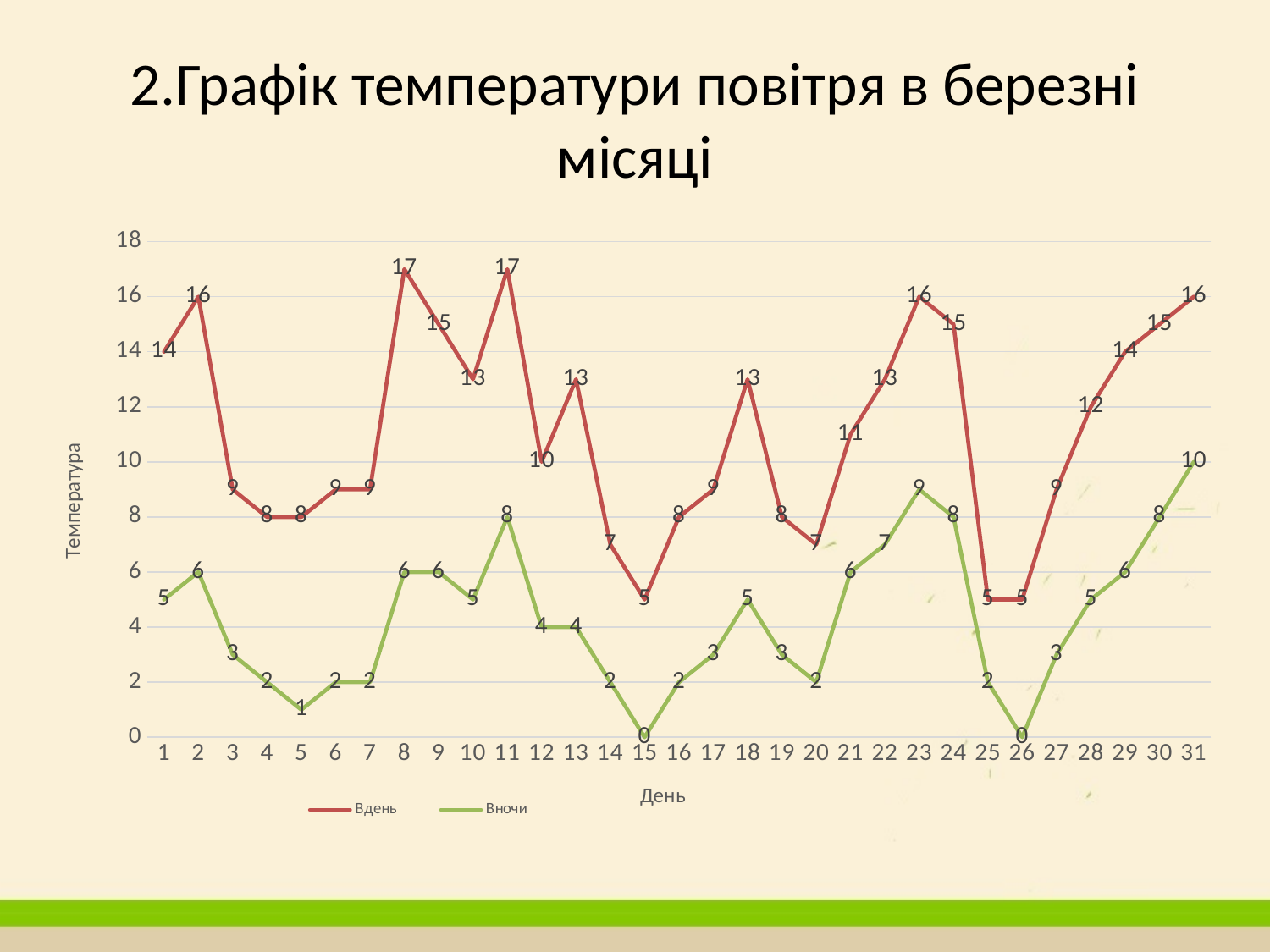
What is the difference between the daytime and night temperatures on day 8? 11 What is the night (Вночи) temperature on day 23? 9 Which has the higher daytime (Вдень) temperature, day 2 or day 3? Day 2 What is the night (Вночи) temperature on day 15? 0 On which day is the night (Вночи) temperature highest? 31 What kind of chart is shown on the slide? Line chart What is the daytime (Вдень) temperature on day 1? 14 What are the two series named in the legend? Вдень and Вночи How many series does the legend list? 2 How many days are plotted on the x axis? 31 What is the daytime (Вдень) temperature on day 15? 5 By how much does the daytime (Вдень) temperature drop from day 11 to day 12? 7